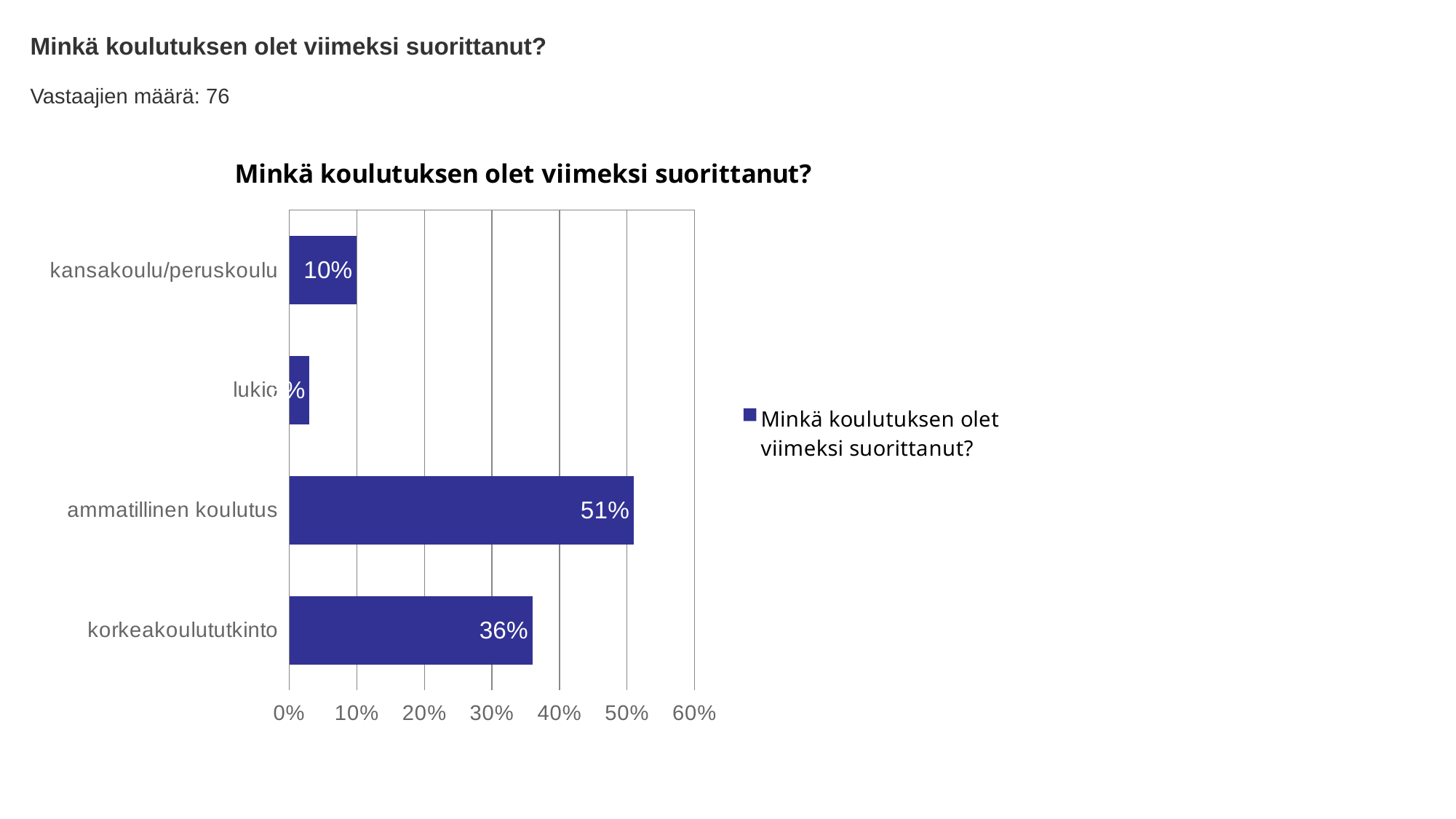
What is the value for korkeakoulututkinto? 36% What is the difference between the values for ammatillinen koulutus and korkeakoulututkinto? 15% What kind of chart is shown on the slide? bar chart Which is larger, the value for korkeakoulututkinto or the value for kansakoulu/peruskoulu? korkeakoulututkinto How many categories are shown in the chart? 4 Which category has the highest value? ammatillinen koulutus What is the difference between the values for korkeakoulututkinto and kansakoulu/peruskoulu? 26% Is the value for lukio greater or less than 10%? less What is the value for kansakoulu/peruskoulu? 10% What is the value for ammatillinen koulutus? 51% What is the title of the chart? Minkä koulutuksen olet viimeksi suorittanut? Which category has the lowest value? lukio